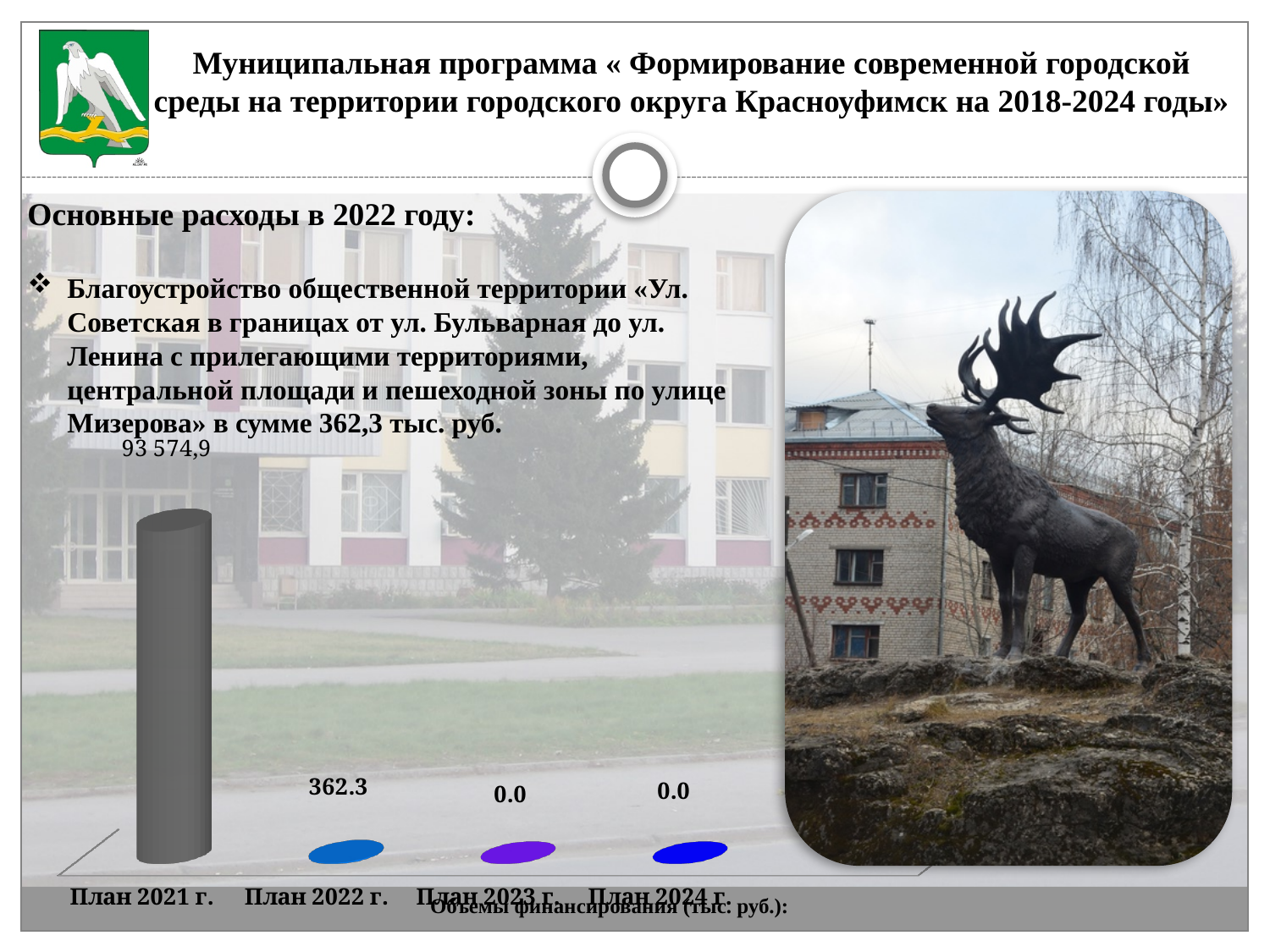
Which category has the highest value? План 2021 г. What is the value for План 2023 г.? 0.0 What kind of chart is shown on the slide? Bar chart Which is larger, the value for План 2021 г. or the value for План 2022 г.? План 2021 г. What is the value for План 2024 г.? 0.0 Do the values rise or fall from План 2021 г. to План 2024 г.? Fall What is the difference between the values for План 2022 г. and План 2023 г.? 362.3 What is the value for План 2021 г.? 93 574,9 What is the value for План 2022 г.? 362.3 What colour is the bar for План 2021 г.? Grey How many categories are shown on the chart? 4